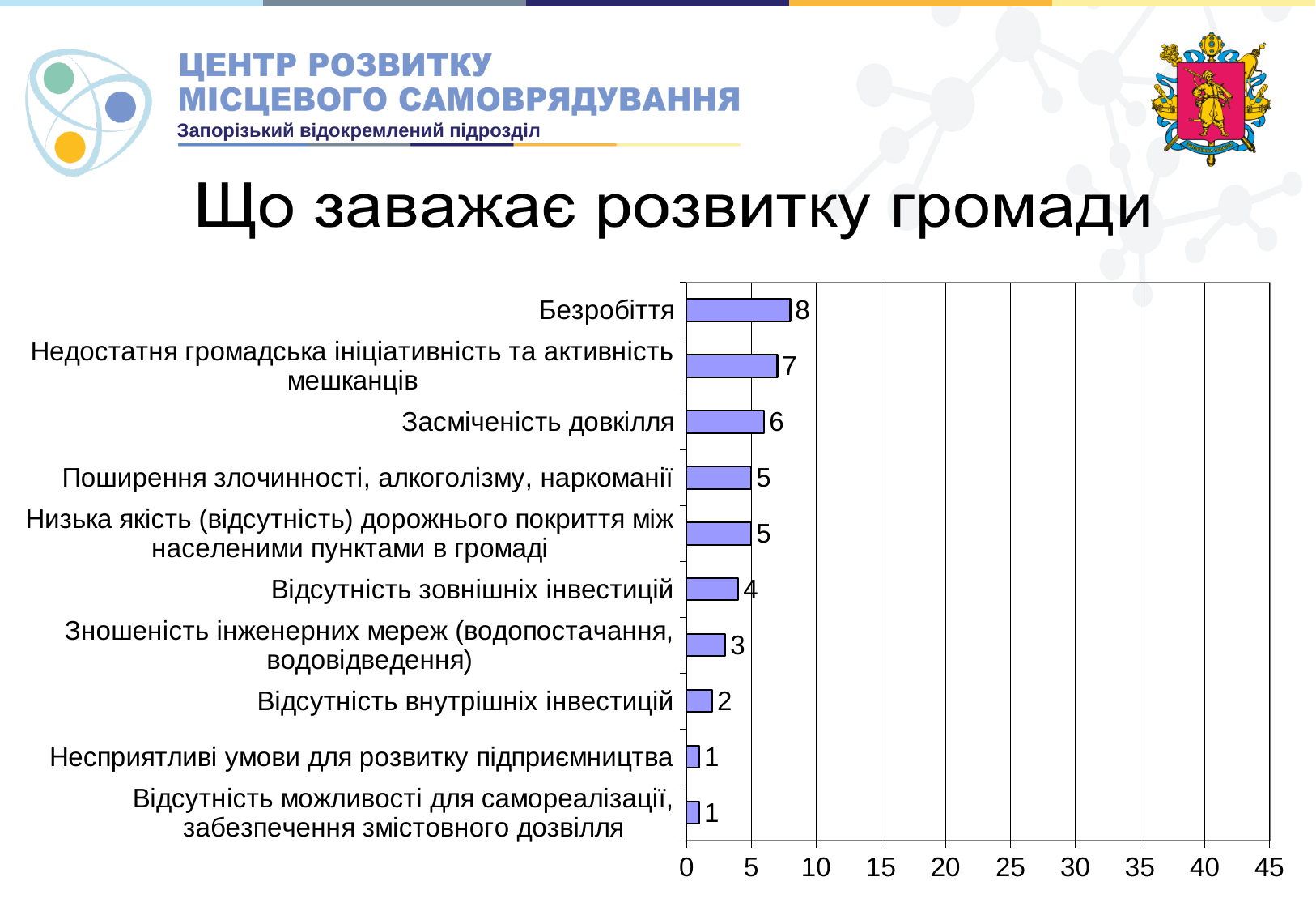
What is the title of the slide? Що заважає розвитку громади What is the value for Відсутність зовнішніх інвестицій? 4 How many categories are shown in the chart? 10 Which is larger: the value for Недостатня громадська ініціативність та активність мешканців or the value for Поширення злочинності, алкоголізму, наркоманії? Недостатня громадська ініціативність та активність мешканців What is the maximum value shown on the horizontal axis? 45 What is the value for Засміченість довкілля? 6 What is the difference between the values for Безробіття and Зношеність інженерних мереж (водопостачання, водовідведення)? 5 What kind of chart is shown on the slide? bar chart Is the value for Безробіття greater or less than 10? less What is the value for Безробіття? 8 Which category has the highest value? Безробіття What is the value for Відсутність внутрішніх інвестицій? 2